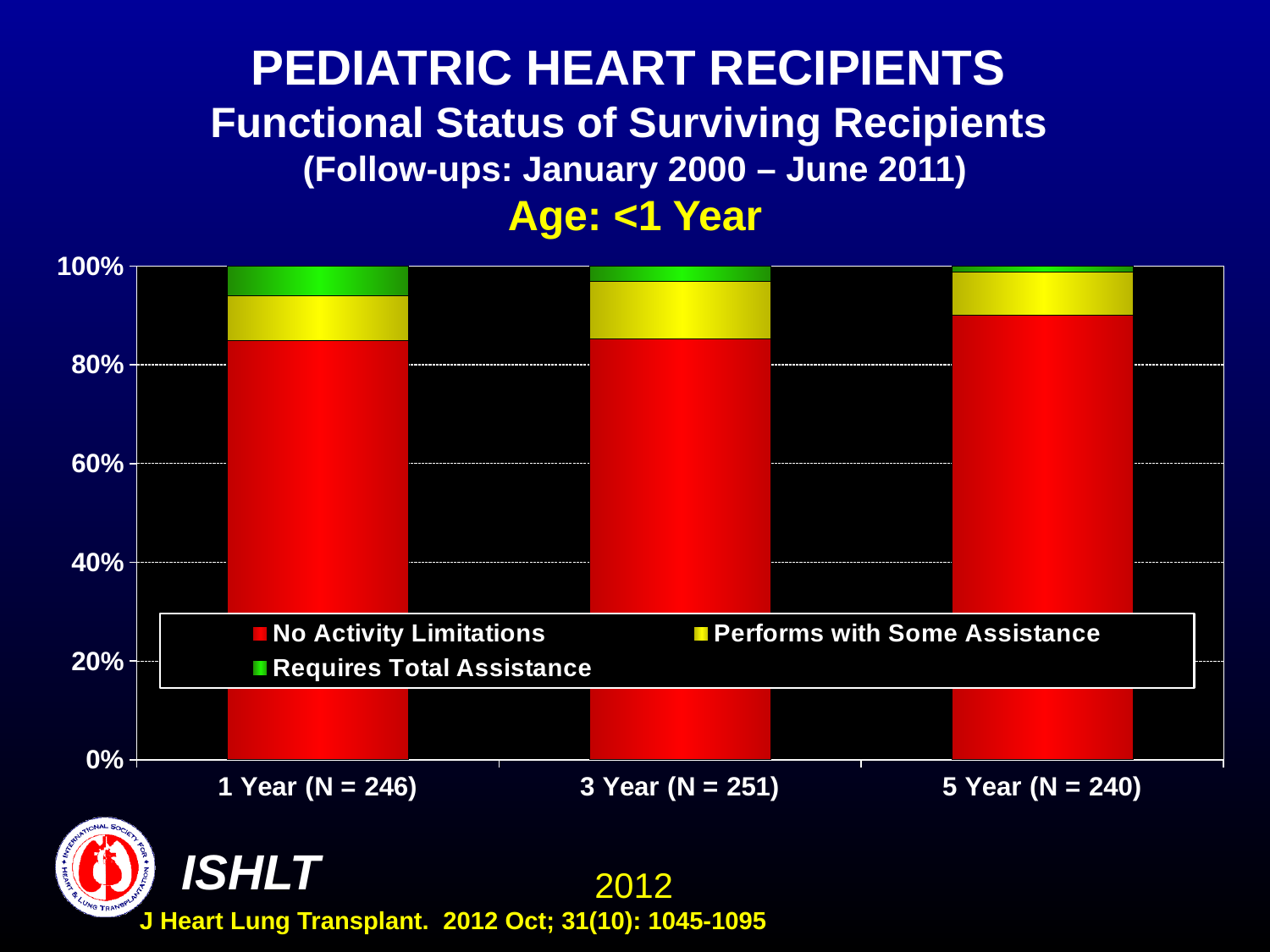
What is the N value shown for the 3 Year category? 251 Which category has the largest No Activity Limitations segment? 5 Year (N = 240) What kind of chart is shown on the slide? Stacked bar chart Is the value for Requires Total Assistance at 5 Year greater or less than 20%? less Does the Requires Total Assistance share rise or fall from 1 Year to 5 Year? fall Which category has the largest Requires Total Assistance segment? 1 Year (N = 246) How many categories (follow-up time points) are shown on the x axis? 3 What is the N value shown for the 5 Year category? 240 Is the value for No Activity Limitations at 1 Year greater or less than 80%? greater How many series does the legend list? 3 Which colour represents Performs with Some Assistance in the legend? Yellow Is the Requires Total Assistance segment larger at 1 Year or at 5 Year? 1 Year